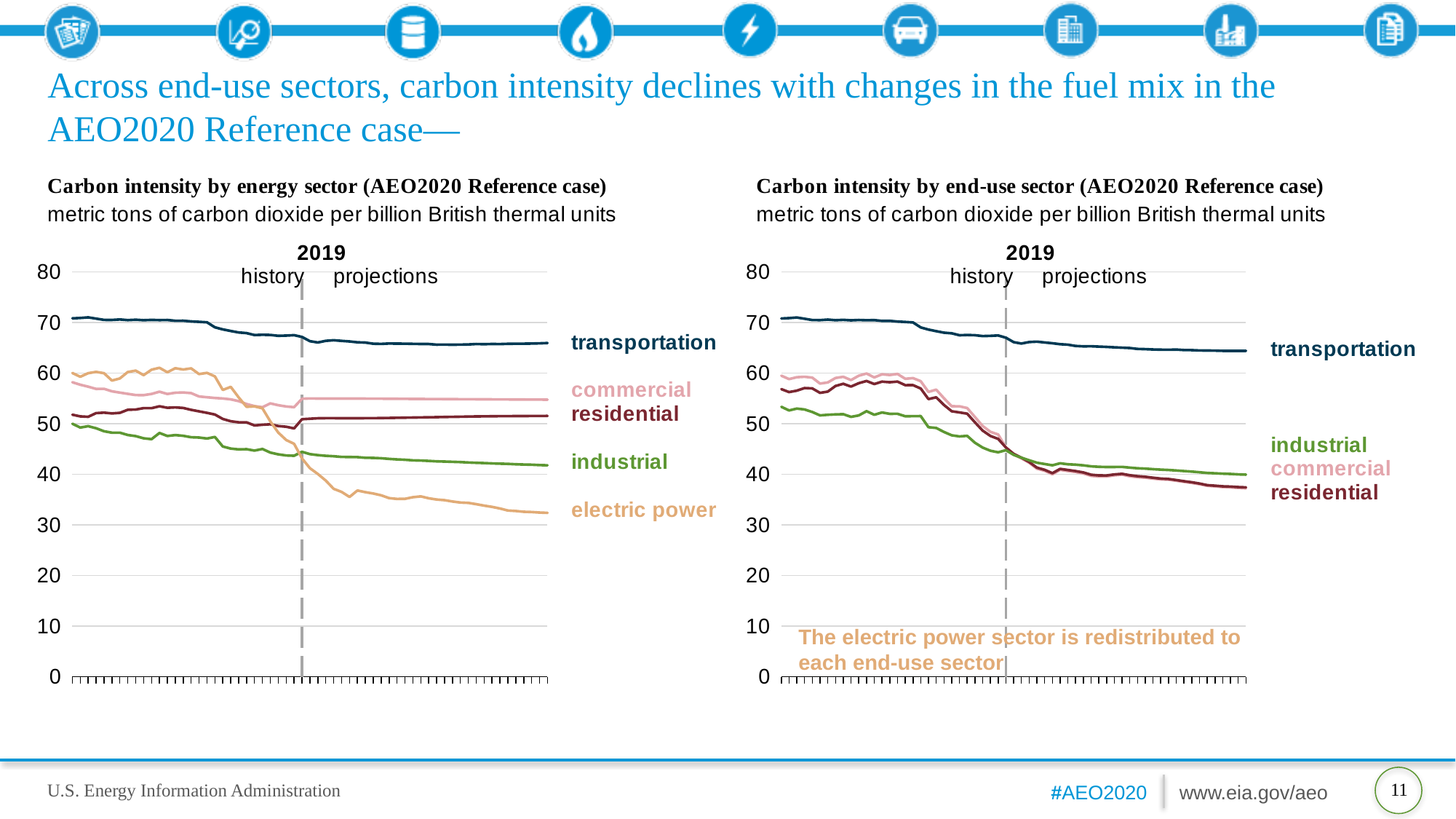
What kind of chart is the 'Carbon intensity by energy sector' chart on the left? line chart In the 'Carbon intensity by energy sector' chart on the left, is the value for electric power at the end of the projection period greater or less than 40? less In the 'Carbon intensity by end-use sector' chart on the right, is the value for transportation at the end of the projection period greater or less than 60? greater In the 'Carbon intensity by energy sector' chart on the left, does the electric power line rise or fall over the period shown? fall In the 'Carbon intensity by end-use sector' chart on the right, is the value for industrial at the end of the projection period greater or less than 50? less What year marks the boundary between history and projections on both charts? 2019 In the 'Carbon intensity by energy sector' chart on the left, which is larger at the end of the projection period: commercial or industrial? commercial How many series are labelled on the 'Carbon intensity by energy sector' chart on the left? 5 In the 'Carbon intensity by end-use sector' chart on the right, which sector has the highest carbon intensity throughout the period? transportation In the 'Carbon intensity by energy sector' chart on the left, which sector has the lowest carbon intensity at the end of the projection period? electric power In the 'Carbon intensity by energy sector' chart on the left, which sector has the highest carbon intensity throughout the period? transportation How many series are labelled on the 'Carbon intensity by end-use sector' chart on the right? 4